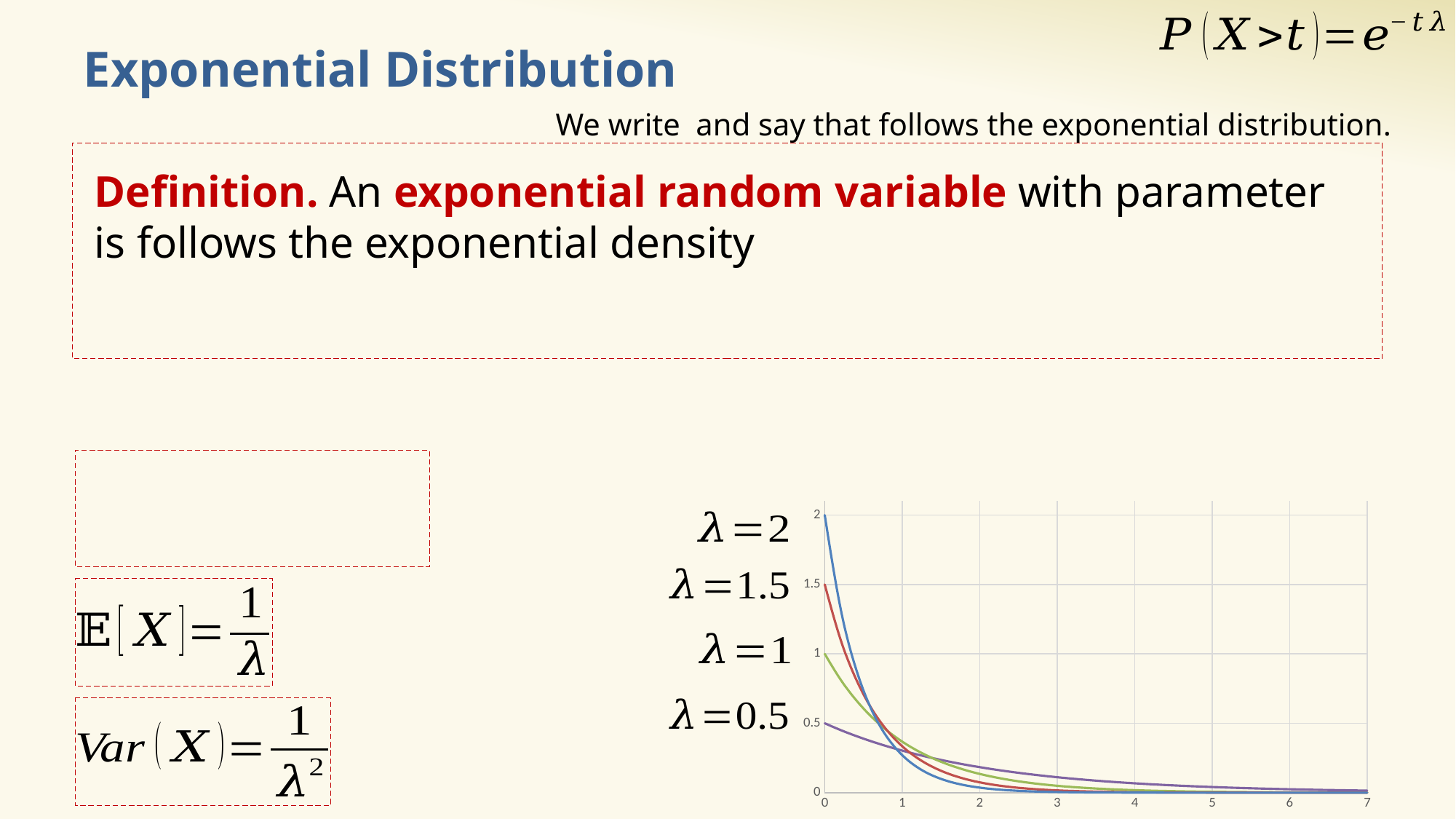
What is the value of the λ = 1.5 curve at x = 0? 1.5 At x = 2, which curve is higher, λ = 0.5 or λ = 2? λ = 0.5 What colour is the λ = 2 curve? blue Do the plotted curves rise or fall as x increases? fall Which curve has the lowest value at x = 0? λ = 0.5 How many curves are plotted on the chart? 4 Which curve has the highest value at x = 0? λ = 2 What kind of chart is shown on the slide? line chart What is the largest value shown on the x axis of the chart? 7 What is the value of the λ = 2 curve at x = 0? 2 Is the value of the λ = 2 curve at x = 1 greater or less than 0.5? less What is the value of the λ = 0.5 curve at x = 0? 0.5